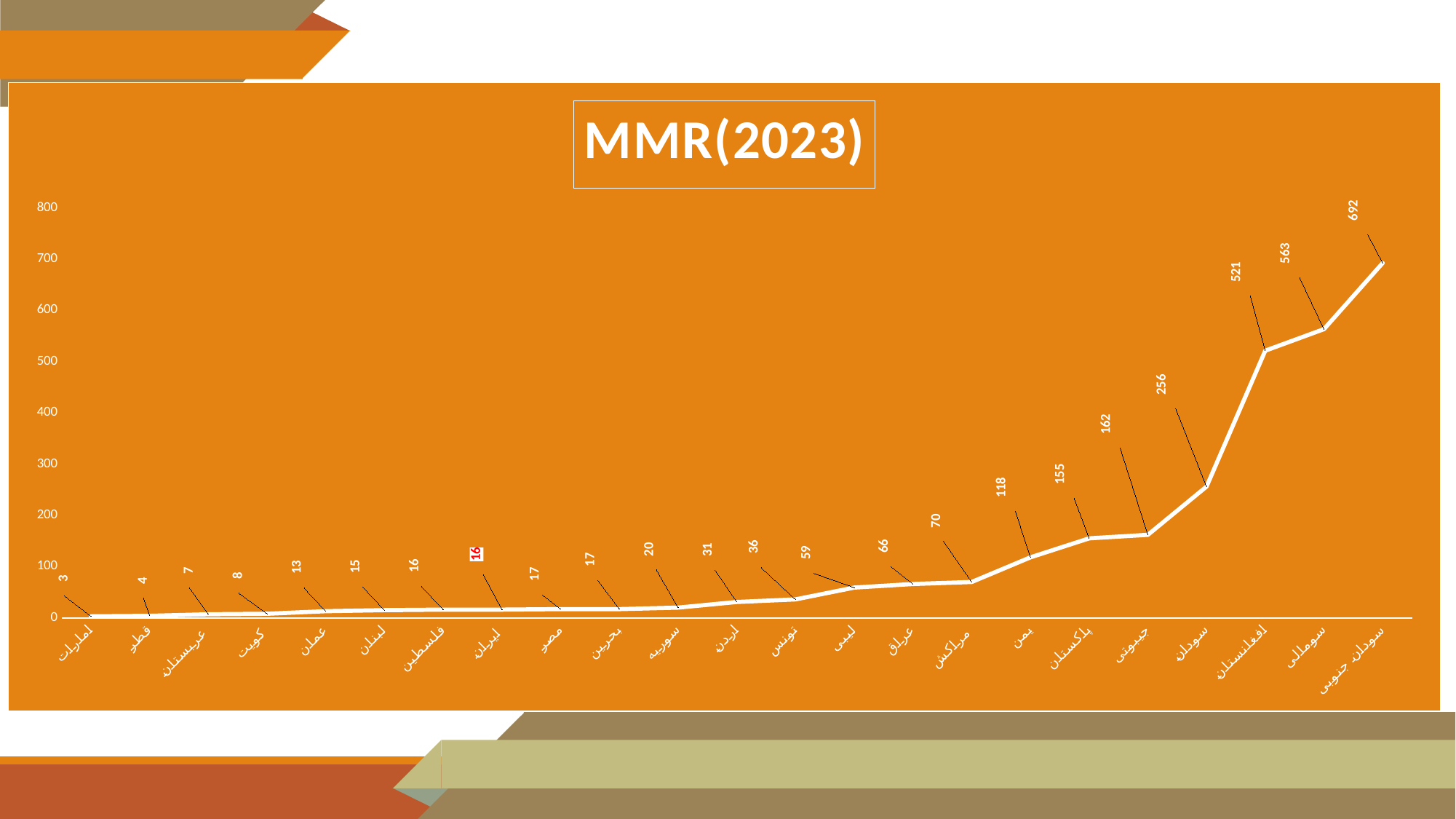
What is the value for پاکستان? 155 What type of chart is shown on the slide? line chart How many categories are plotted on the x axis? 23 Which category has the lowest value? امارات What is the title of the chart? MMR(2023) Is the value for افغانستان greater or less than 500? greater What is the value for ایران? 16 What is the value for سودان جنوبی? 692 What is the difference between the values for سومالی and افغانستان? 42 Do the values rise or fall from left to right along the x axis? rise Which category has the highest value? سودان جنوبی Which has a larger value, سودان or یمن? سودان